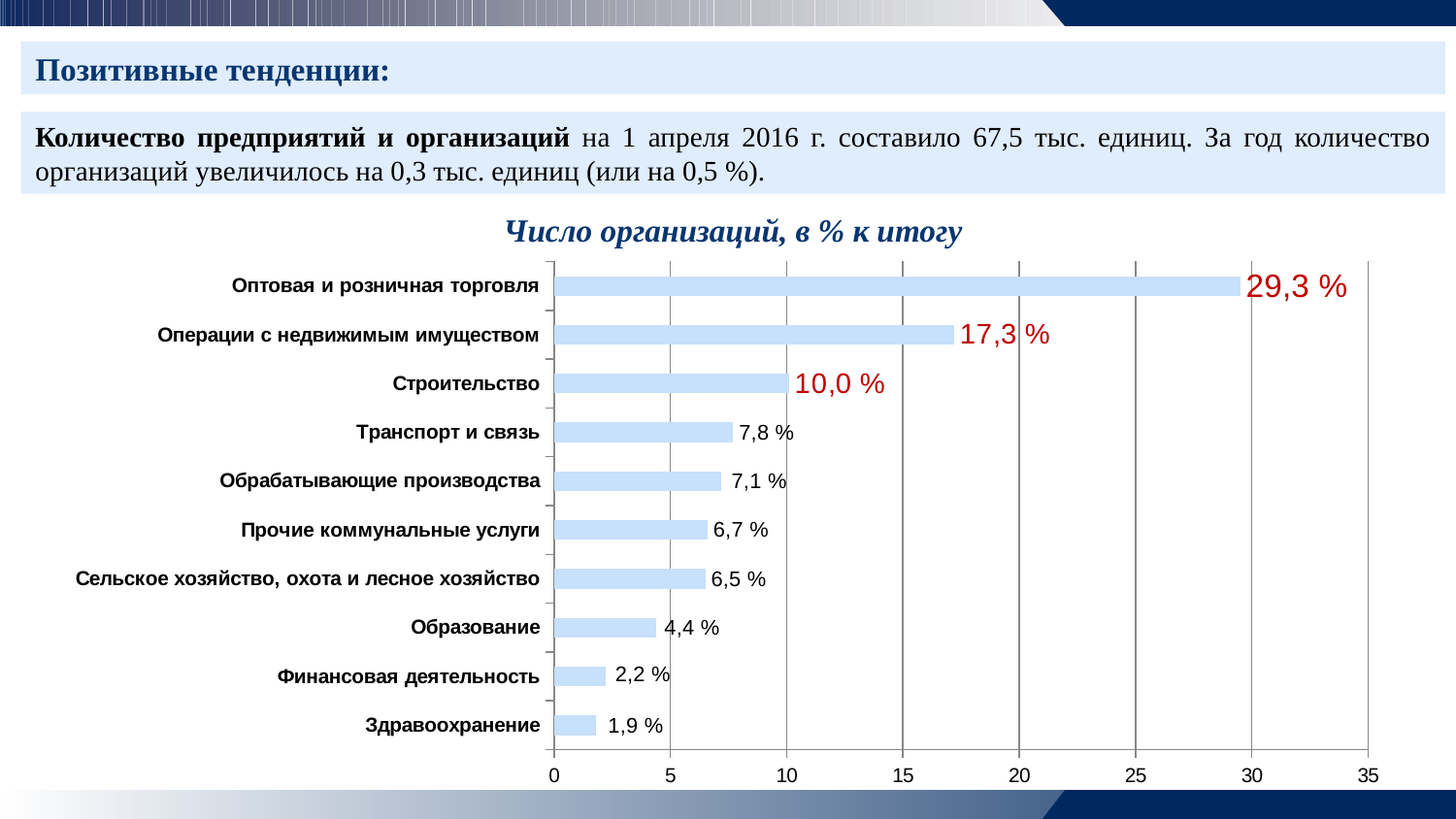
Is the value for Операции с недвижимым имуществом greater or less than 15? greater How many categories are shown in the chart? 10 Which category has the highest value? Оптовая и розничная торговля What kind of chart is shown on the slide? bar chart What is the difference between the values for Оптовая и розничная торговля and Операции с недвижимым имуществом? 12,0 % What is the value for Образование? 4,4 % What is the difference between the values for Транспорт и связь and Обрабатывающие производства? 0,7 % Which is larger: the value for Финансовая деятельность or the value for Здравоохранение? Финансовая деятельность Which category has the lowest value? Здравоохранение What is the value for Строительство? 10,0 % What is the value for Оптовая и розничная торговля in the chart 'Число организаций, в % к итогу'? 29,3 % What is the title of the chart? Число организаций, в % к итогу